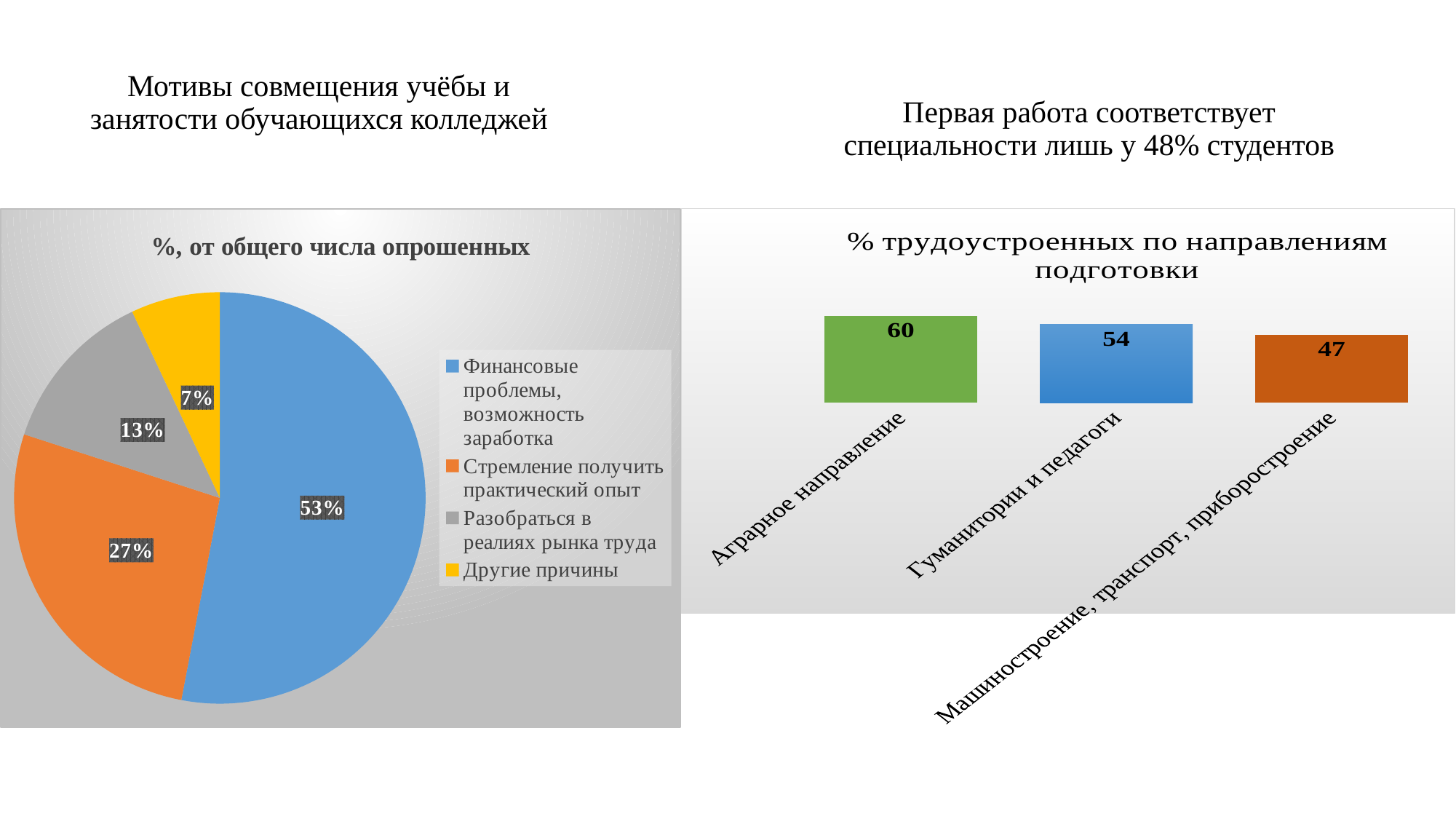
In the chart '% трудоустроенных по направлениям подготовки', what is the value for 'Аграрное направление'? 60 In the pie chart '%, от общего числа опрошенных', which category has the largest slice? Финансовые проблемы, возможность заработка What kind of chart is '% трудоустроенных по направлениям подготовки'? Bar chart In the pie chart '%, от общего числа опрошенных', how many categories does the legend list? 4 In the chart '% трудоустроенных по направлениям подготовки', what is the value for 'Машиностроение, транспорт, приборостроение'? 47 In the pie chart '%, от общего числа опрошенных', what share is labelled for 'Финансовые проблемы, возможность заработка'? 53% In the pie chart '%, от общего числа опрошенных', which category has the smallest slice? Другие причины In the chart '% трудоустроенных по направлениям подготовки', which category has the lowest value? Машиностроение, транспорт, приборостроение In the chart '% трудоустроенных по направлениям подготовки', what is the difference between 'Аграрное направление' and 'Гуманитории и педагоги'? 6 In the pie chart '%, от общего числа опрошенных', what share is labelled for 'Другие причины'? 7% In the pie chart '%, от общего числа опрошенных', what is the difference between the shares for 'Стремление получить практический опыт' and 'Разобраться в реалиях рынка труда'? 14% In the pie chart '%, от общего числа опрошенных', what share is labelled for 'Стремление получить практический опыт'? 27%